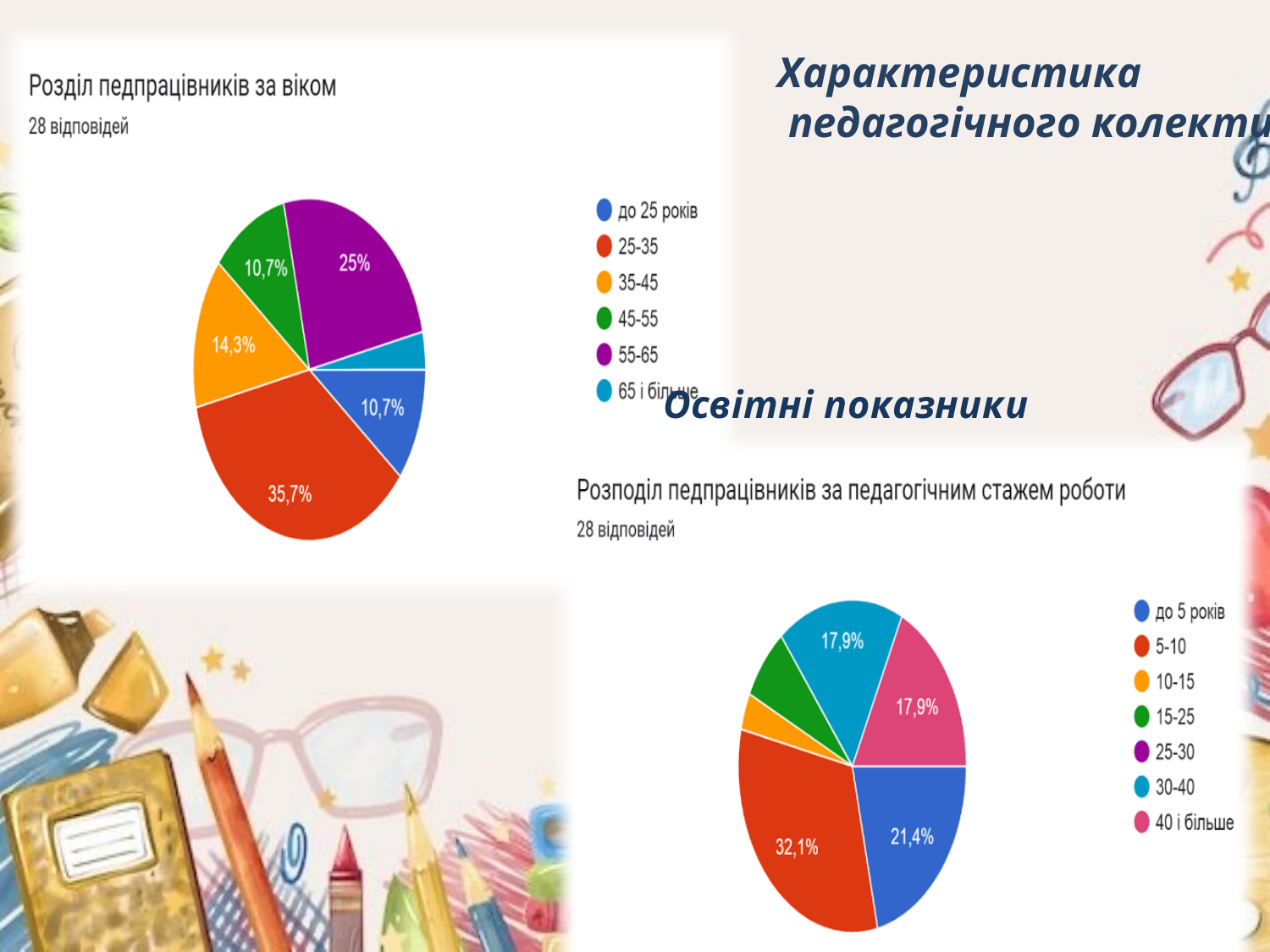
On the chart titled "Розділ педпрацівників за віком", how many percentage points larger is the 25-35 share than the 55-65 share? 10,7 On the chart titled "Розділ педпрацівників за віком", what share of respondents are in the 25-35 age group? 35,7% On the chart titled "Розподіл педпрацівників за педагогічним стажем роботи", how many categories does the legend list? 7 On the chart titled "Розділ педпрацівників за віком", what share of respondents are in the 55-65 age group? 25% What type of chart is used for "Розподіл педпрацівників за педагогічним стажем роботи"? Pie chart On the chart titled "Розподіл педпрацівників за педагогічним стажем роботи", which is larger: the share for 5-10 years or the share for 30-40 years? 5-10 On the chart titled "Розділ педпрацівників за віком", which age group has the smallest share? 65 і більше On the chart titled "Розподіл педпрацівників за педагогічним стажем роботи", what share of respondents have up to 5 years of experience (до 5 років)? 21,4% On the chart titled "Розділ педпрацівників за віком", how many categories does the legend list? 6 On the chart titled "Розподіл педпрацівників за педагогічним стажем роботи", what share of respondents have 5-10 years of experience? 32,1% On the chart titled "Розділ педпрацівників за віком", what share of respondents are in the 35-45 age group? 14,3% On the chart titled "Розділ педпрацівників за віком", which age group has the largest share? 25-35